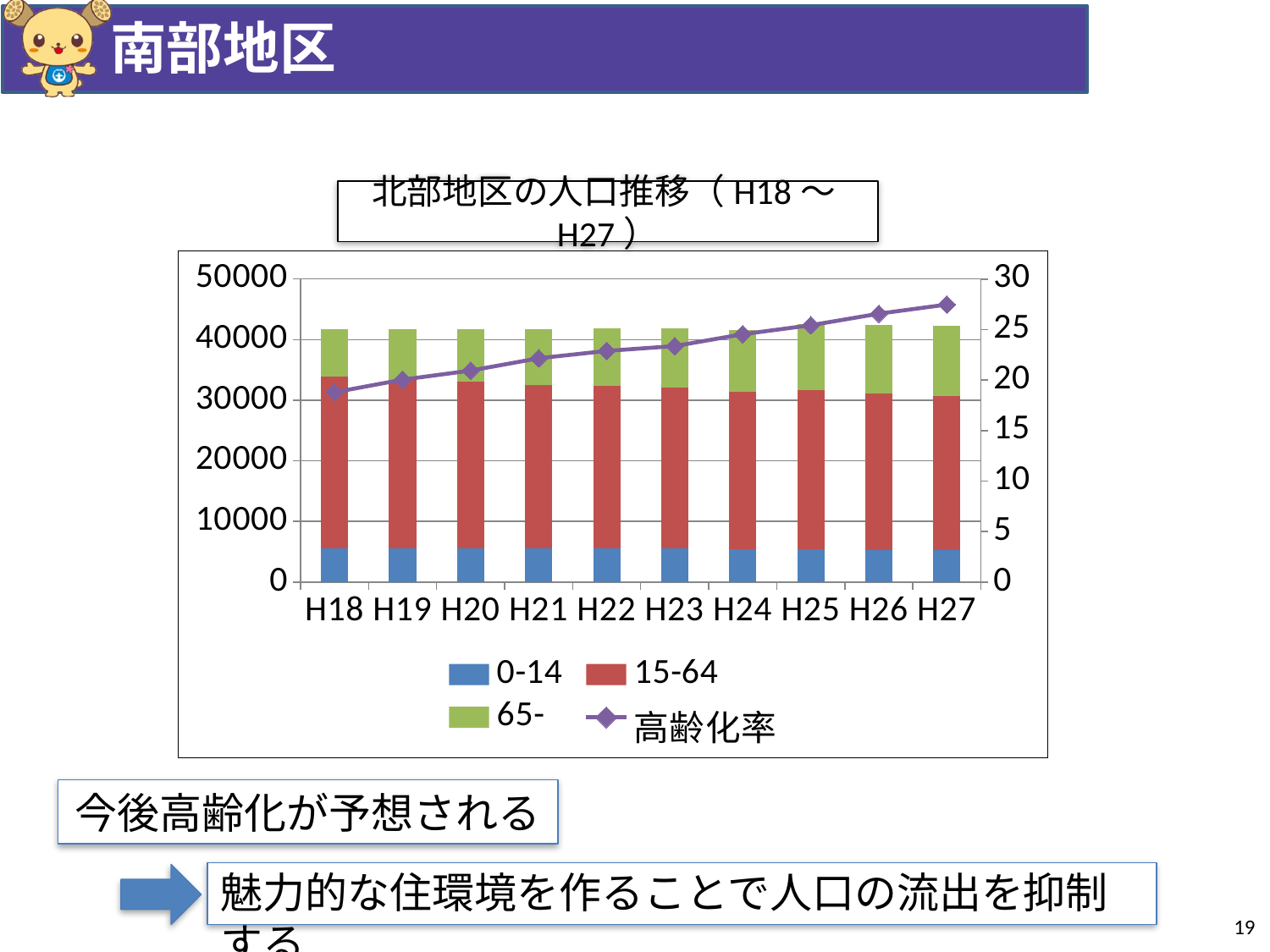
In which year is the 高齢化率 value highest? H27 Is the 高齢化率 value for H27 greater or less than 25 on the right axis? greater How many series does the legend list? 4 What is the title of the chart? 北部地区の人口推移（H18～H27） In which year is the 高齢化率 value lowest? H18 Is the 0-14 segment for H18 greater or less than 10000? less What kind of chart is shown on the slide? A stacked bar chart combined with a line chart How many years (categories) are shown on the x axis? 10 Is the 高齢化率 value for H18 greater or less than 20 on the right axis? less Which series is plotted as a line with diamond markers? 高齢化率 Does the 高齢化率 line rise or fall from H18 to H27? Rises